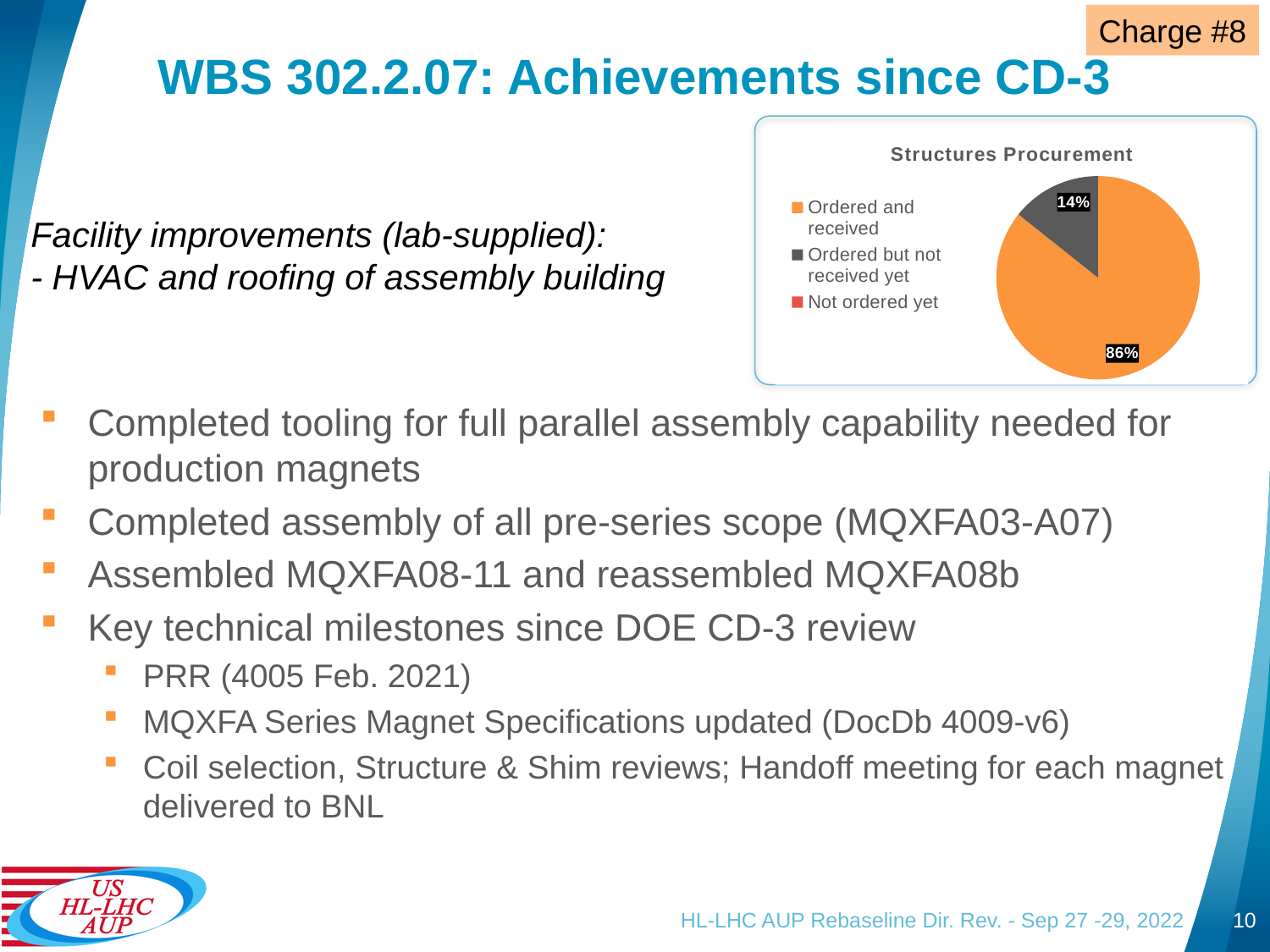
How many slices of the pie have a percentage label printed on them? 2 What colour is the 'Ordered and received' slice of the pie? orange What is the title of the chart on the slide? Structures Procurement What is the difference in percentage points between the 'Ordered and received' slice and the 'Ordered but not received yet' slice? 72 percentage points What kind of chart is shown on the slide? pie chart What share of the pie is labelled for 'Ordered but not received yet'? 14% Which category has the largest slice of the pie? Ordered and received Which of the two labelled slices is smaller, 'Ordered and received' or 'Ordered but not received yet'? Ordered but not received yet What share of the pie is labelled for 'Ordered and received'? 86% How many entries does the chart's legend list? 3 Is the 'Ordered and received' slice larger or smaller than the 'Ordered but not received yet' slice? larger